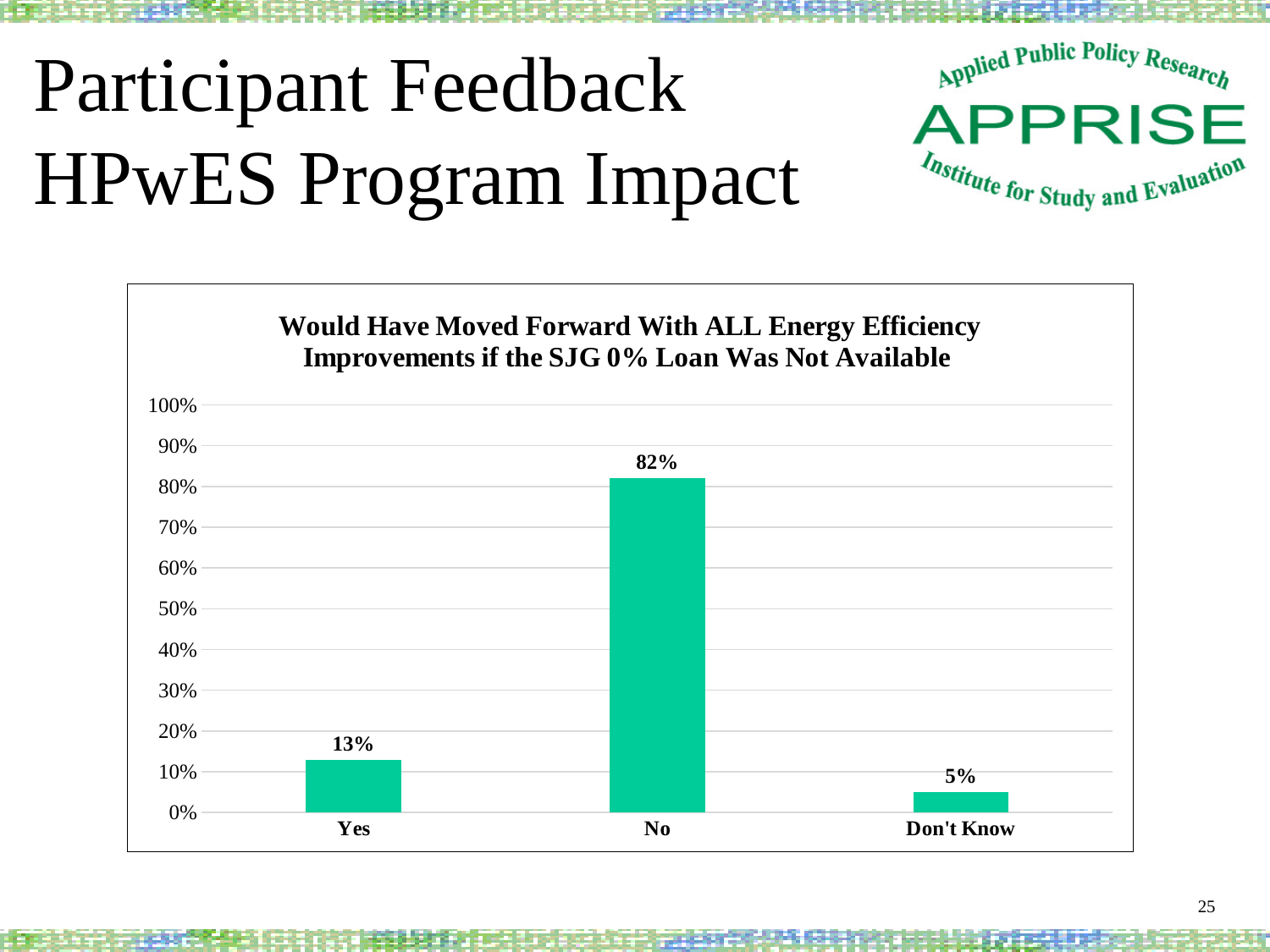
How many response categories are shown on the x axis? 3 What is the title of the chart? Would Have Moved Forward With ALL Energy Efficiency Improvements if the SJG 0% Loan Was Not Available Which is larger, the value for "Yes" or the value for "Don't Know"? Yes What is the difference between the "Yes" and "Don't Know" percentages? 8% What percentage of participants answered "No"? 82% What percentage of participants answered "Yes"? 13% What kind of chart is shown on the slide? Bar chart What is the difference between the "No" and "Yes" percentages? 69% Is the value for "No" greater or less than 50%? greater Which response category has the lowest value? Don't Know What percentage of participants answered "Don't Know"? 5% Which response category has the highest value? No